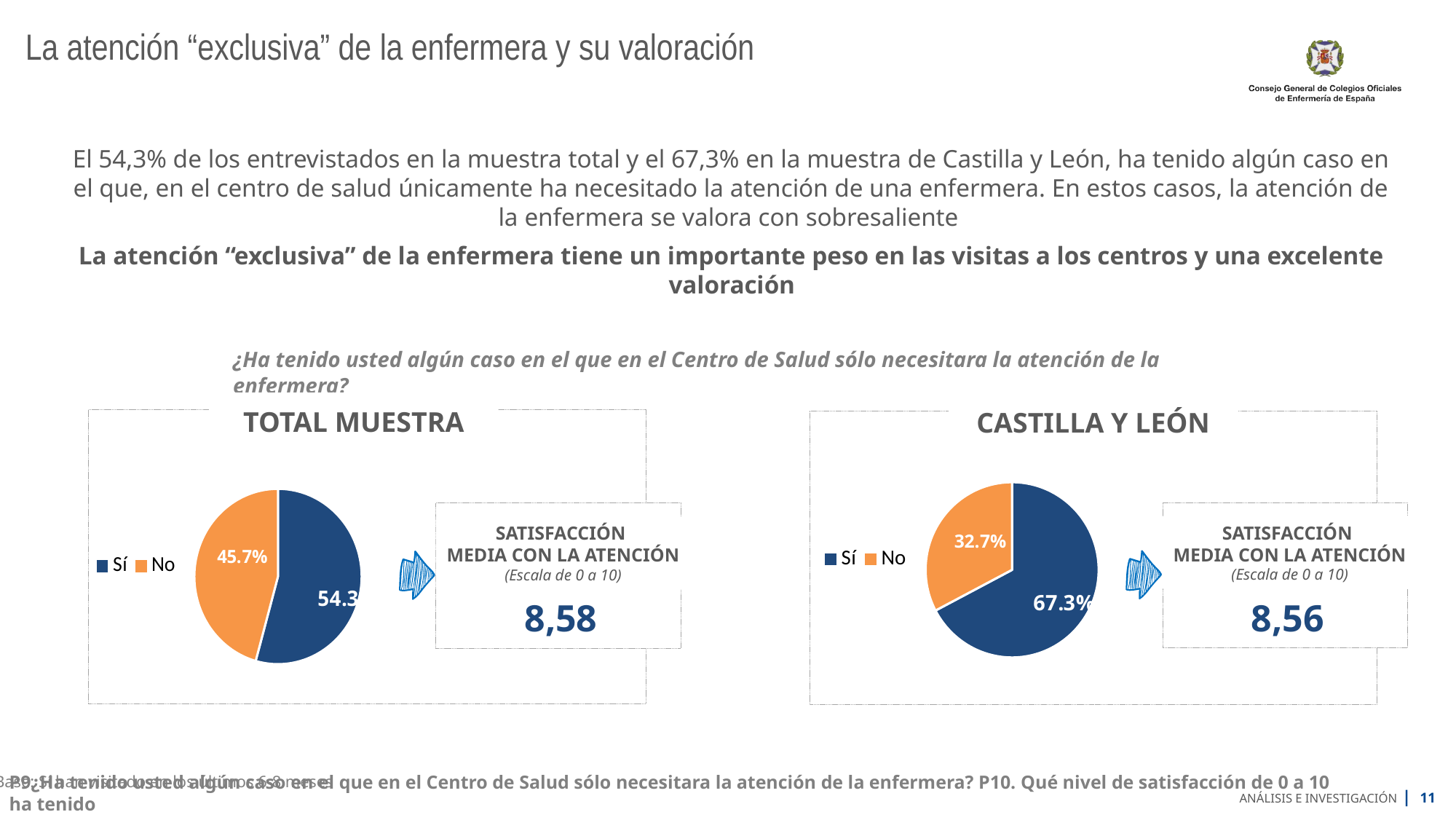
Is the No share in the CASTILLA Y LEÓN chart greater or less than the No share in the TOTAL MUESTRA chart? less In the TOTAL MUESTRA chart, what percentage of respondents answered Sí? 54.3% In the CASTILLA Y LEÓN chart, what percentage of respondents answered No? 32.7% In the CASTILLA Y LEÓN chart, what is the difference in percentage points between Sí and No? 34.6 In the TOTAL MUESTRA chart, which slice is larger, Sí or No? Sí How many entries does the legend of the TOTAL MUESTRA chart list? 2 In the CASTILLA Y LEÓN chart, what colour is the Sí slice? Dark blue In the CASTILLA Y LEÓN chart, which category has the smallest slice? No In the TOTAL MUESTRA chart, what percentage of respondents answered No? 45.7% What type of chart is used under TOTAL MUESTRA? Pie chart In the CASTILLA Y LEÓN chart, what percentage of respondents answered Sí? 67.3% How many slices does the CASTILLA Y LEÓN pie chart have? 2